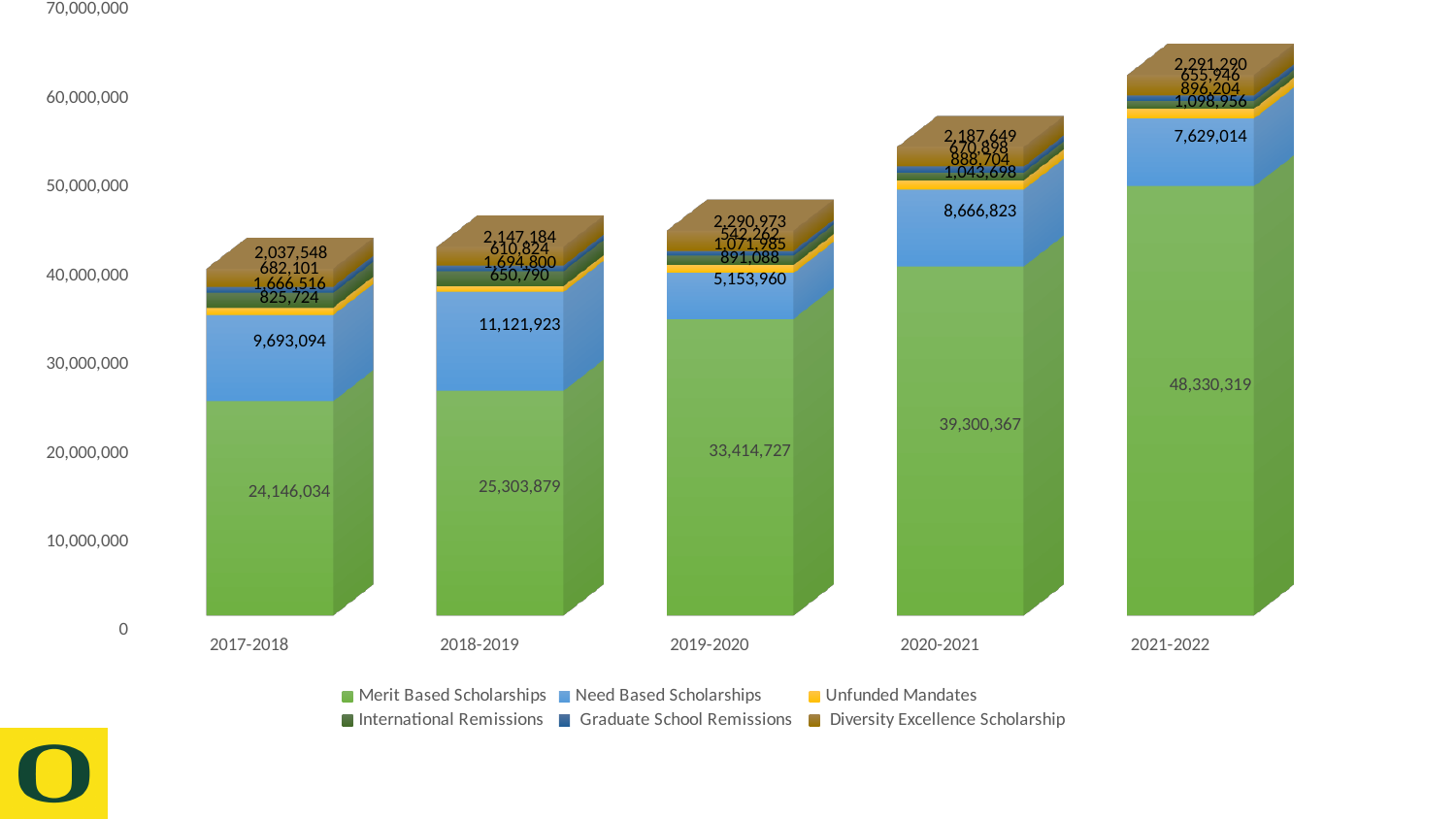
In which year is Merit Based Scholarships highest? 2021-2022 How many series does the legend list? 6 What kind of chart is shown on the slide? Stacked bar chart How many academic years are shown on the x axis? 5 What is the value of Need Based Scholarships for 2018-2019? 11,121,923 What is the value of Merit Based Scholarships for 2021-2022? 48,330,319 What is the value of Merit Based Scholarships for 2019-2020? 33,414,727 Which year has the larger Need Based Scholarships value, 2017-2018 or 2020-2021? 2017-2018 In which year is Need Based Scholarships lowest? 2019-2020 Is the total height of the 2017-2018 bar greater or less than 50,000,000? less Do Merit Based Scholarships rise or fall from 2017-2018 to 2021-2022? Rise By how much did Merit Based Scholarships increase from 2017-2018 to 2021-2022? 24,184,285